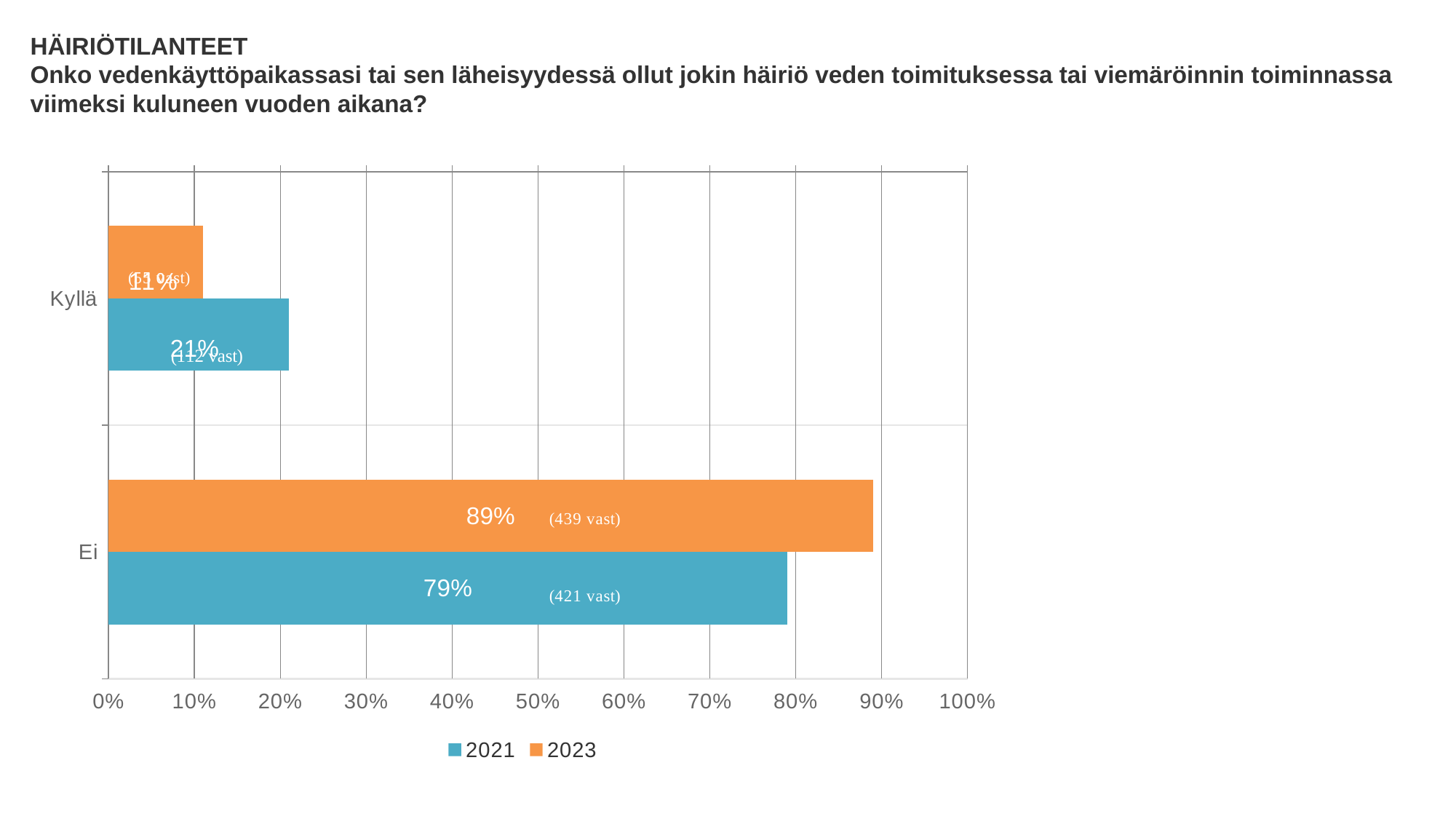
What is the value for Ei in the 2023 series? 89% How many series does the legend list? 2 What is the value for Kyllä in the 2023 series? 11% How many respondents are shown for Ei in the 2023 series? 439 vast What kind of chart is shown on the slide? bar chart Which series has the larger value for Kyllä, 2021 or 2023? 2021 How many respondents are shown for Ei in the 2021 series? 421 vast What is the difference between the 2023 and 2021 values for Ei? 10% Which colour represents the 2023 series? orange What is the value for Ei in the 2021 series? 79% What is the value for Kyllä in the 2021 series? 21% How many categories are shown on the vertical axis? 2